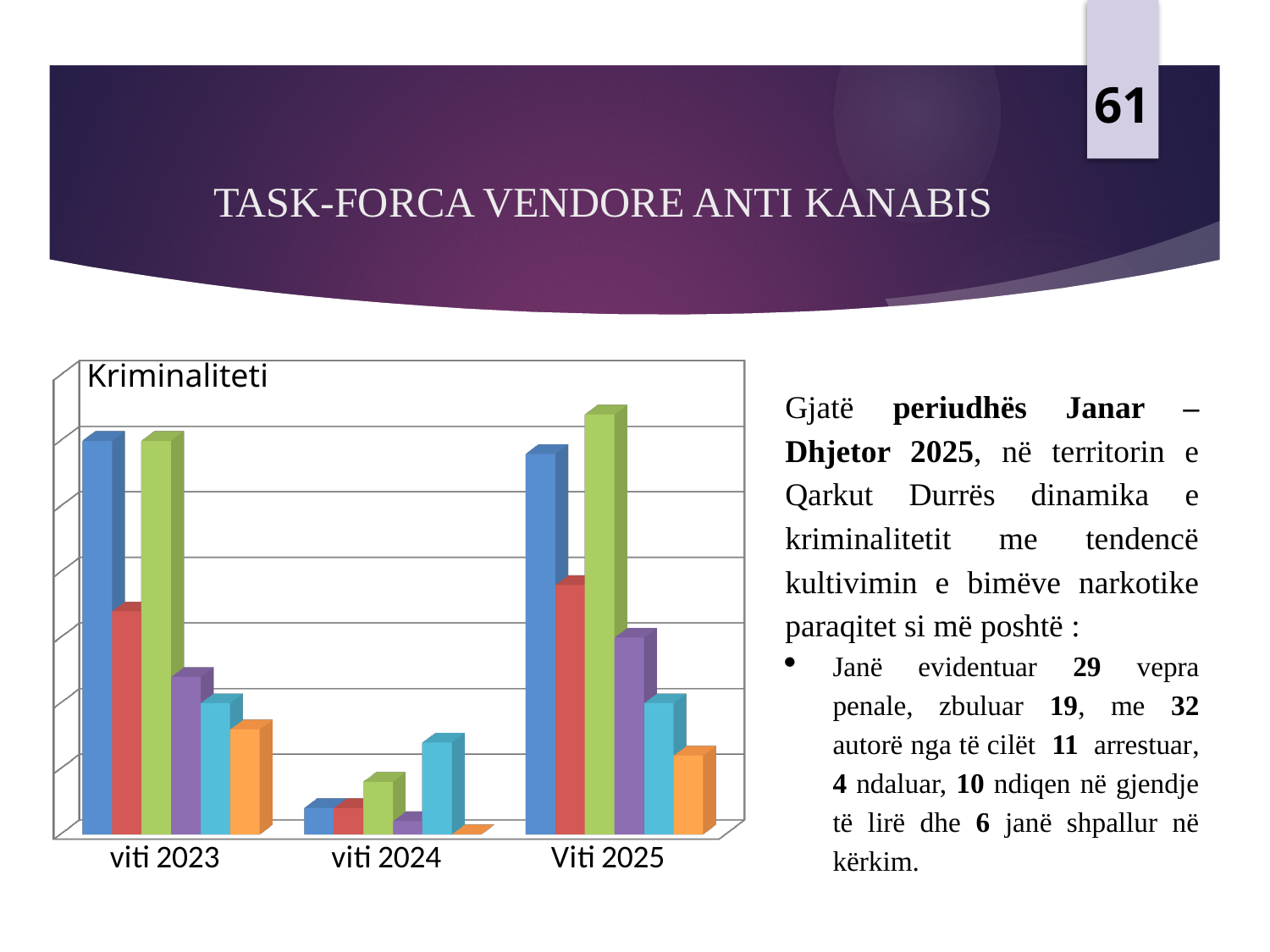
How many bars are shown for the category viti 2023? 6 What colour is the tallest bar in the Viti 2025 group? green Is the red bar larger in viti 2023 or in Viti 2025? Viti 2025 How many categories are shown on the x axis of the chart? 3 In viti 2023, which is larger, the blue bar or the red bar? blue bar What kind of chart is shown on the slide? bar chart Does the blue bar rise or fall from viti 2023 to viti 2024? fall Which category has the tallest green bar? Viti 2025 In viti 2024, which is larger, the cyan bar or the blue bar? cyan bar Does the green bar rise or fall from viti 2024 to Viti 2025? rise Which category has the lowest blue bar? viti 2024 What is the title of the chart? Kriminaliteti